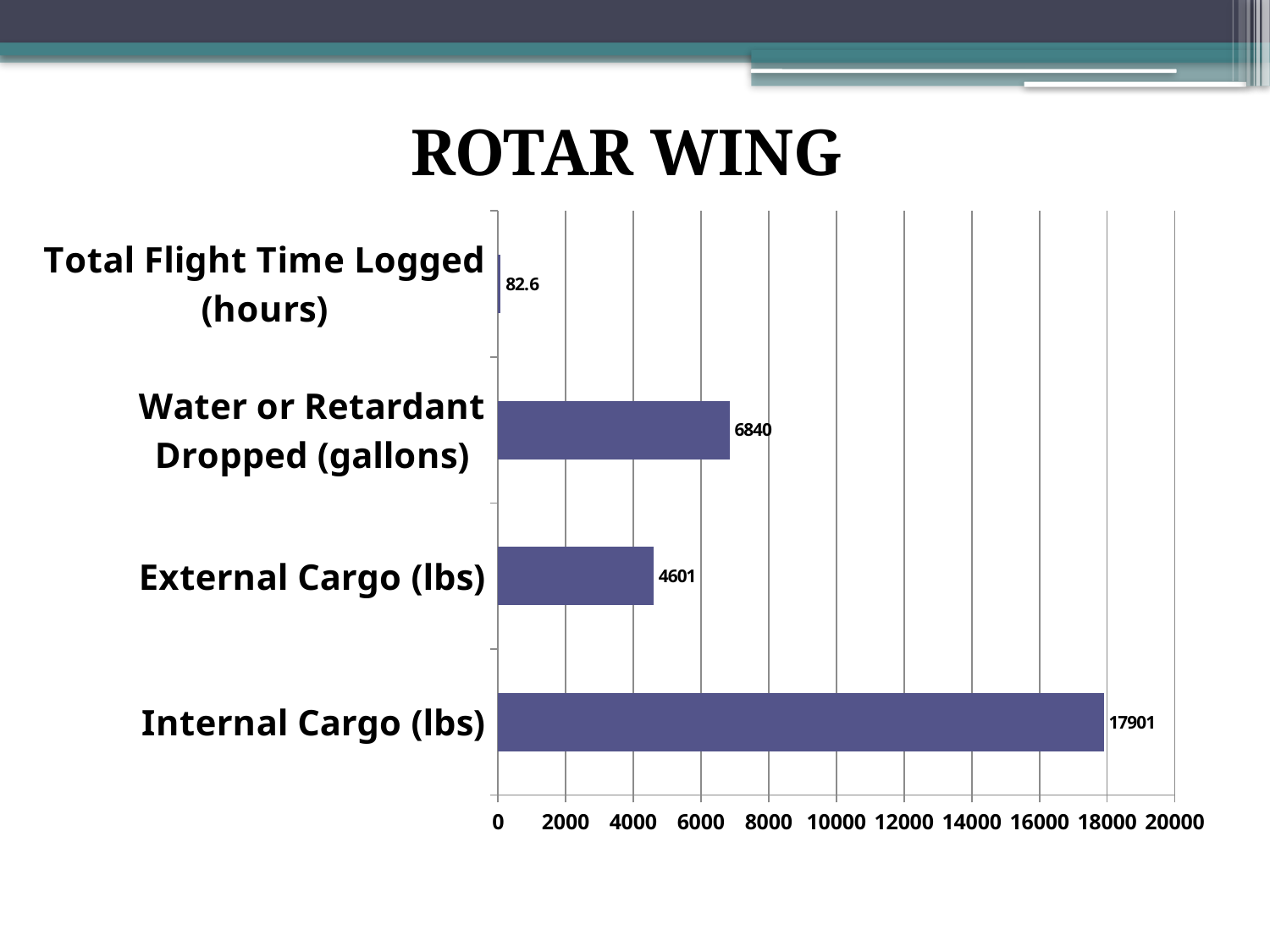
What is the value for Internal Cargo (lbs)? 17901 Which category has the lowest value? Total Flight Time Logged (hours) What is the value for Water or Retardant Dropped (gallons)? 6840 What is the difference between Water or Retardant Dropped (gallons) and External Cargo (lbs)? 2239 What is the difference between Internal Cargo (lbs) and External Cargo (lbs)? 13300 What type of chart is shown on the slide? bar chart How many categories are shown in the chart? 4 Which category has the highest value? Internal Cargo (lbs) Is the value for Internal Cargo (lbs) greater or less than 16000? greater Which is larger, Water or Retardant Dropped (gallons) or External Cargo (lbs)? Water or Retardant Dropped (gallons) What is the value for External Cargo (lbs)? 4601 What is the value for Total Flight Time Logged (hours)? 82.6